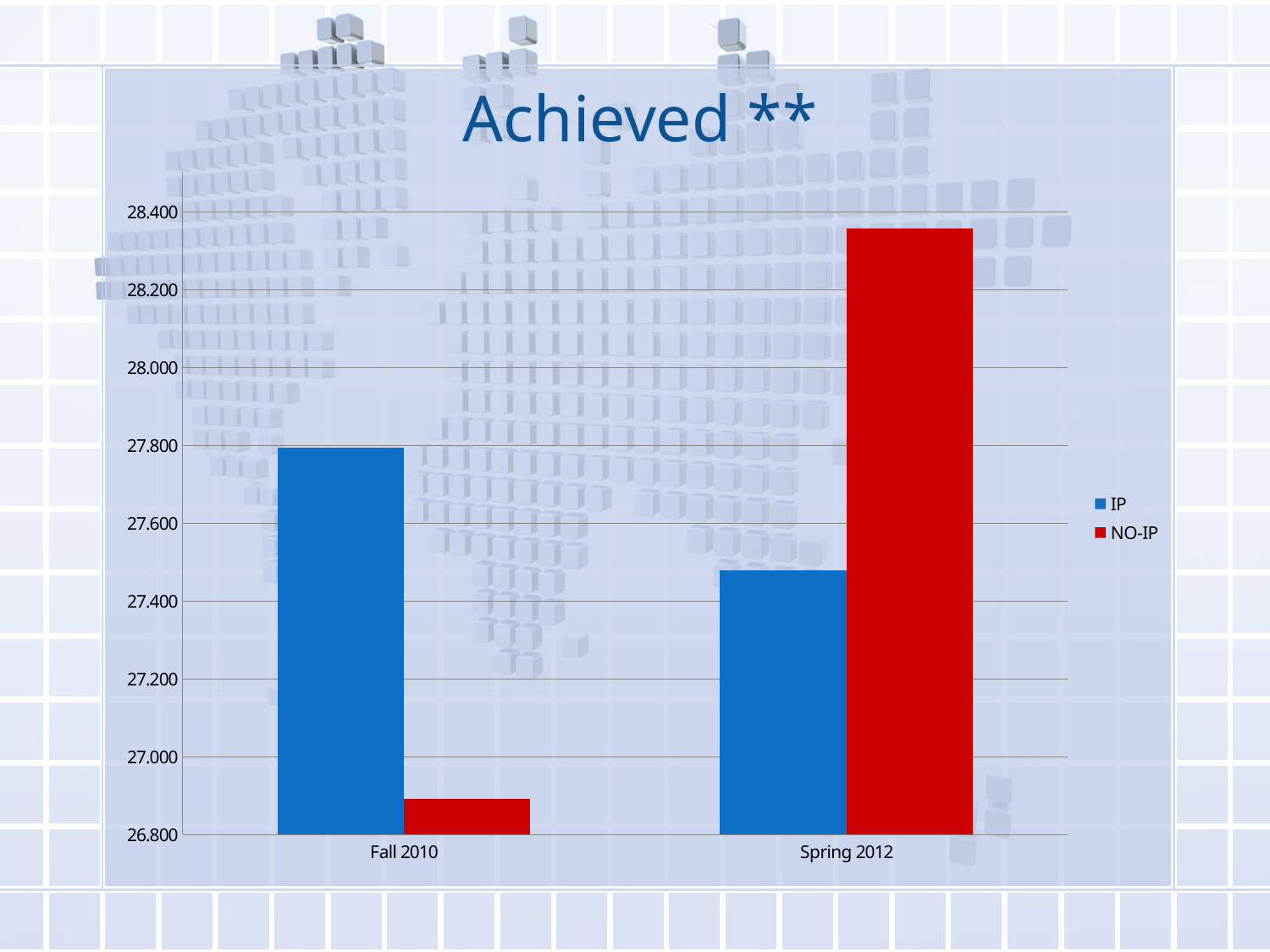
Does the IP series rise or fall from Fall 2010 to Spring 2012? fall How many categories are shown on the x axis? 2 Which bar is the lowest in the chart? NO-IP in Fall 2010 Which series is shown in red in the legend? NO-IP In Fall 2010, which is larger, IP or NO-IP? IP In Spring 2012, which is larger, IP or NO-IP? NO-IP What is the title of the chart? Achieved ** What kind of chart is shown on the slide? bar chart Is the value for IP in Fall 2010 greater or less than 27.600? greater Is the value for NO-IP in Fall 2010 greater or less than 27.000? less Which bar is the highest in the chart? NO-IP in Spring 2012 How many series does the legend list? 2